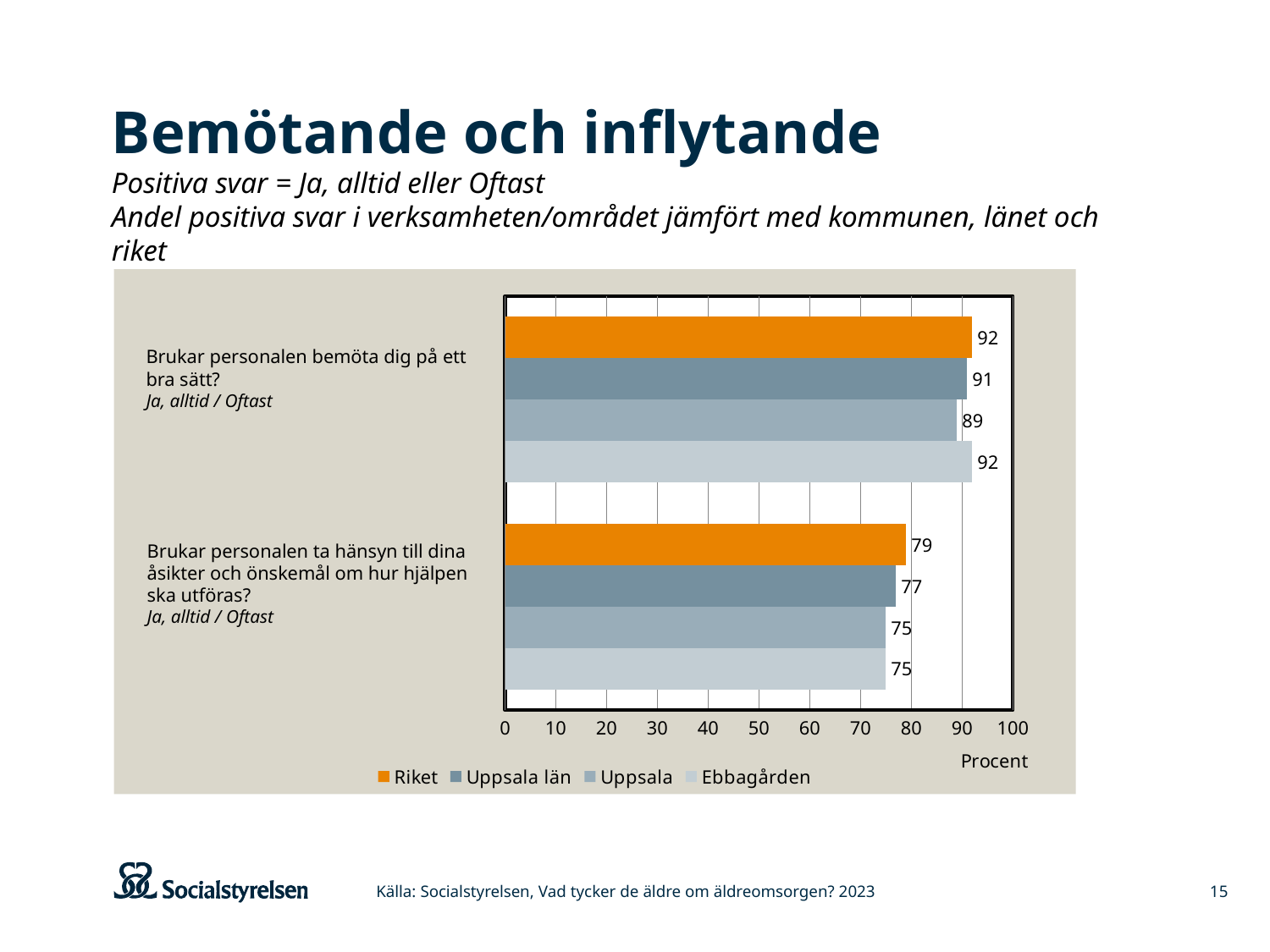
What value is shown for Riket on the question "Brukar personalen bemöta dig på ett bra sätt?"? 92 What unit label is shown on the horizontal axis of the chart? Procent What kind of chart is shown on the slide? Bar chart Which series has the lowest value on the question "Brukar personalen bemöta dig på ett bra sätt?"? Uppsala What value is shown for Ebbagården on the question "Brukar personalen bemöta dig på ett bra sätt?"? 92 How many series does the legend list? 4 Which is larger: the Uppsala län value for "Brukar personalen bemöta dig på ett bra sätt?" or the Uppsala län value for "Brukar personalen ta hänsyn till dina åsikter och önskemål om hur hjälpen ska utföras?"? Brukar personalen bemöta dig på ett bra sätt? What value is shown for Uppsala on the question "Brukar personalen ta hänsyn till dina åsikter och önskemål om hur hjälpen ska utföras?"? 75 What is the difference between the Riket value and the Uppsala value on the question "Brukar personalen bemöta dig på ett bra sätt?"? 3 What is the difference between the Riket value and the Ebbagården value on the question "Brukar personalen ta hänsyn till dina åsikter och önskemål om hur hjälpen ska utföras?"? 4 What value is shown for Uppsala län on the question "Brukar personalen ta hänsyn till dina åsikter och önskemål om hur hjälpen ska utföras?"? 77 Which series has the highest value on the question "Brukar personalen ta hänsyn till dina åsikter och önskemål om hur hjälpen ska utföras?"? Riket